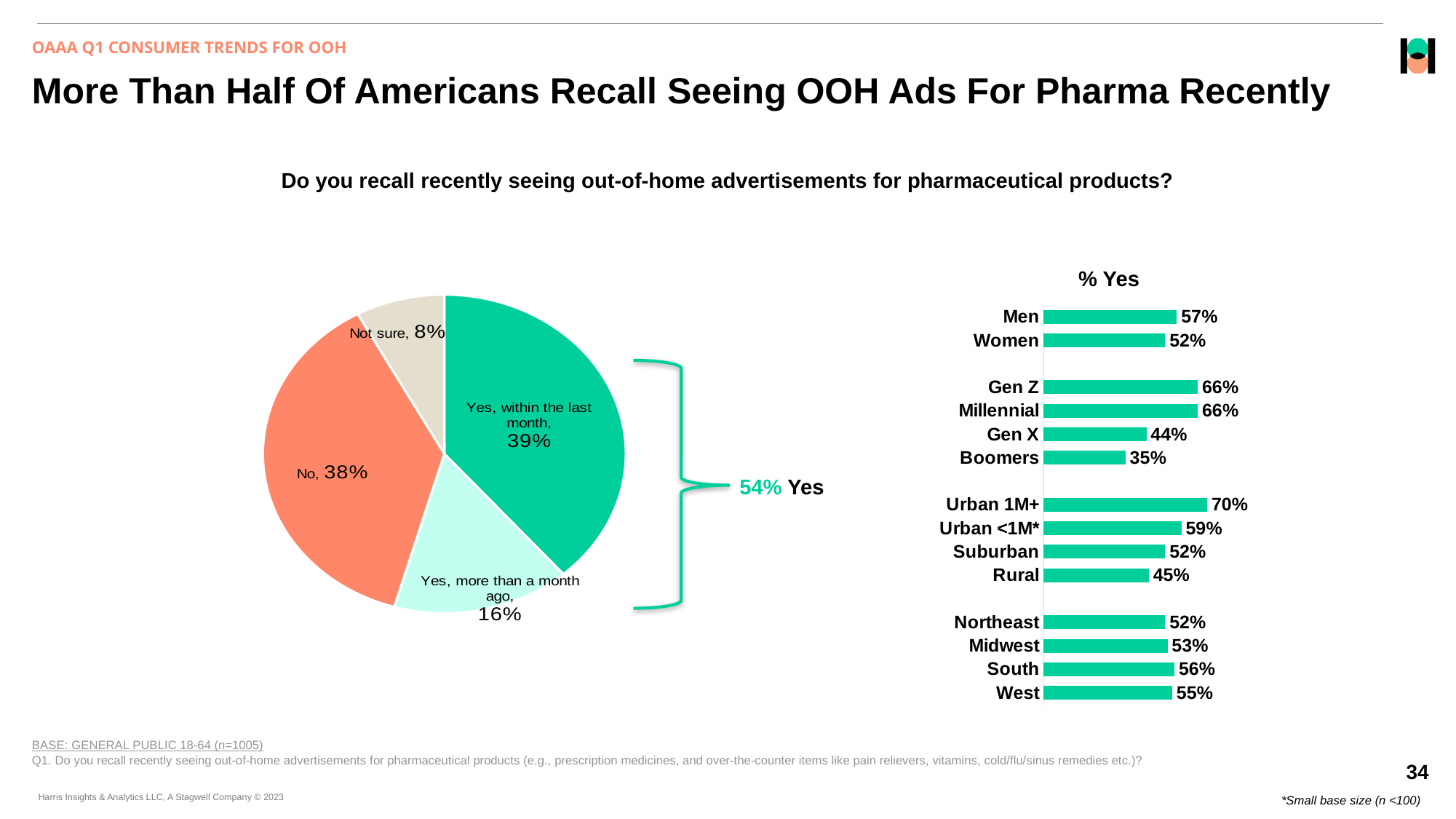
In the pie chart on the left, what is the combined percentage for the two "Yes" responses, as labelled on the slide? 54% In the pie chart on the left, how many slices are there? 4 In the "% Yes" bar chart on the right, what is the value for Boomers? 35% In the "% Yes" bar chart on the right, which is larger, Gen X or Rural? Rural In the "% Yes" bar chart on the right, which category has the highest value? Urban 1M+ In the pie chart on the left, which response has the smallest slice? Not sure In the pie chart on the left, what share of respondents said "Yes, within the last month"? 39% In the pie chart on the left, what percentage of respondents answered "No"? 38% In the "% Yes" bar chart on the right, what is the difference between Men and Women? 5% What type of chart is shown on the right side of the slide? Bar chart In the "% Yes" bar chart on the right, which category has the lowest value? Boomers In the "% Yes" bar chart on the right, how many categories are shown? 14